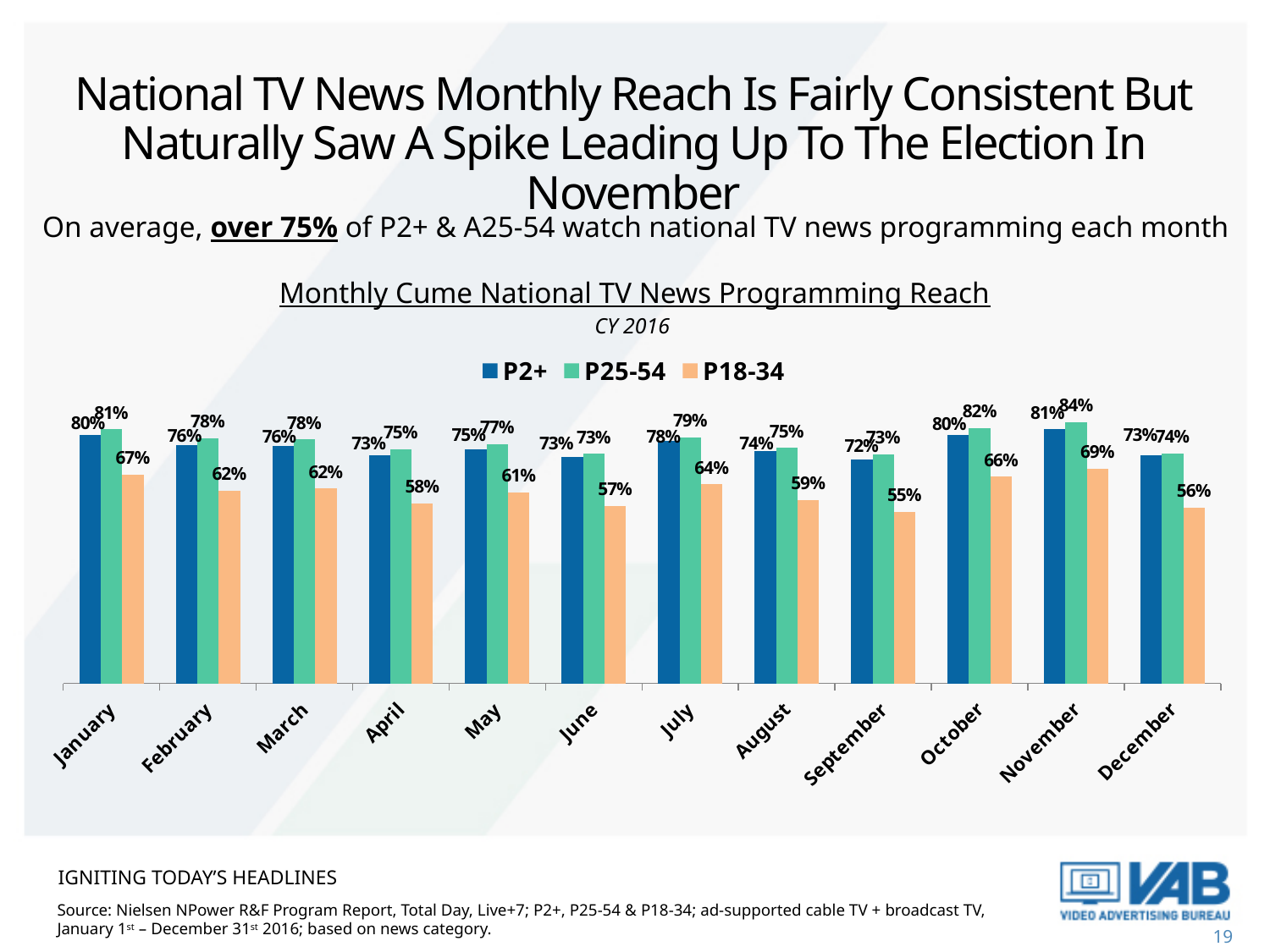
What is the difference between the P25-54 and P18-34 reach in November? 15% Which month has the lowest P18-34 reach? September What is the title of the chart? Monthly Cume National TV News Programming Reach Which is larger, the P2+ reach in January or the P2+ reach in December? January What is the P25-54 reach value for October? 82% How many months are shown on the x axis? 12 Which month has the highest P25-54 reach? November Which series is shown in orange in the legend? P18-34 What is the P2+ reach value for January? 80% How many series does the legend list? 3 What is the P18-34 reach value for November? 69% What kind of chart is shown on the slide? Bar chart